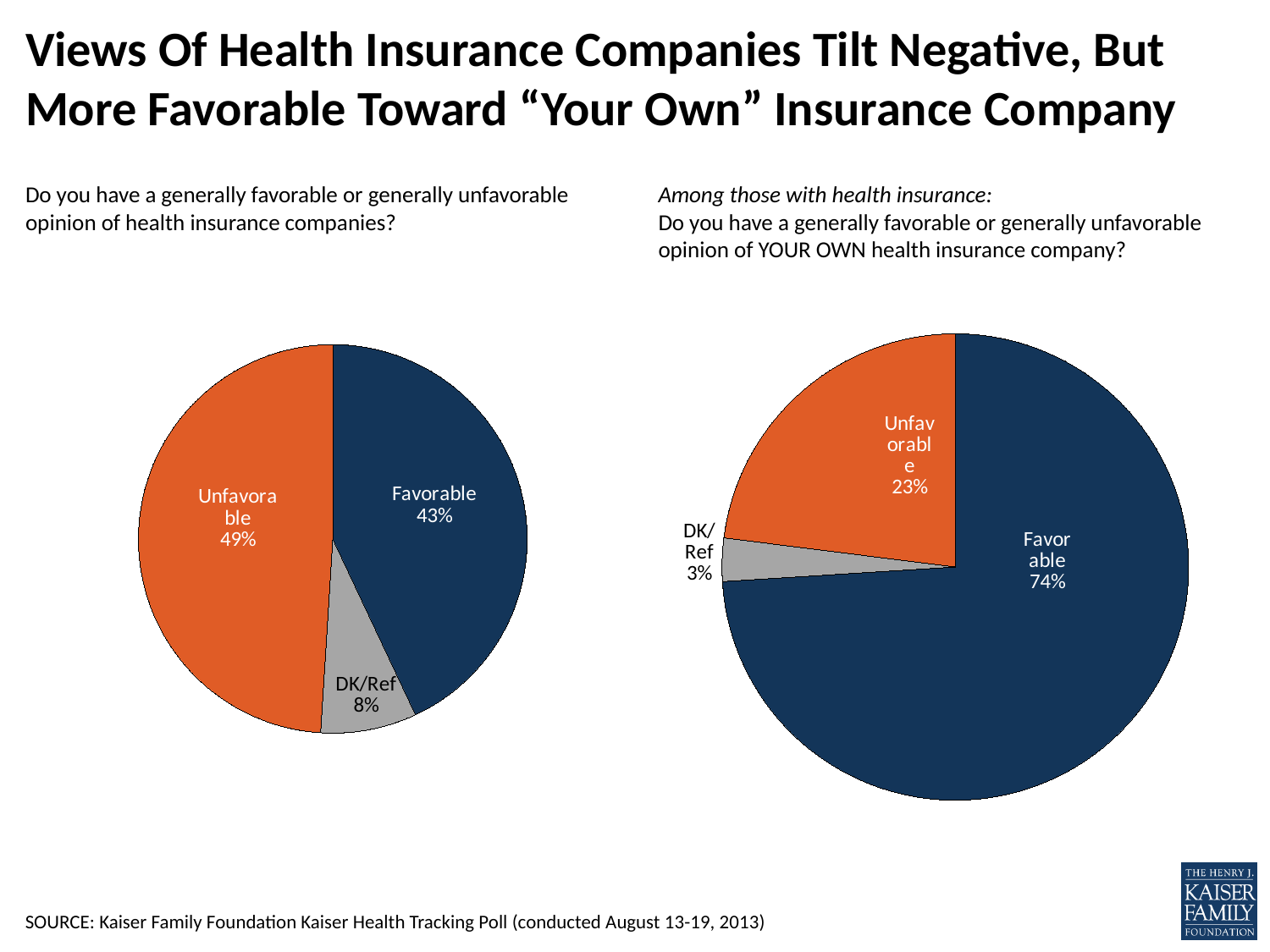
In the left pie chart (opinion of health insurance companies), what is the difference between the Unfavorable and Favorable shares? 6 percentage points In the right pie chart (opinion of YOUR OWN health insurance company), what is the difference between the Favorable and Unfavorable shares? 51 percentage points What type of chart is used on this slide? Pie chart In the right pie chart (opinion of YOUR OWN health insurance company), what colour is the Favorable slice? Dark blue Is the Favorable share larger in the left pie chart (health insurance companies) or the right pie chart (YOUR OWN health insurance company)? The right pie chart (YOUR OWN health insurance company) In the right pie chart (opinion of YOUR OWN health insurance company), what share of respondents are Favorable? 74% In the right pie chart (opinion of YOUR OWN health insurance company), what share of respondents are DK/Ref? 3% In the left pie chart (opinion of health insurance companies), what share of respondents are Favorable? 43% How many slices does the left pie chart (opinion of health insurance companies) have? 3 In the right pie chart (opinion of YOUR OWN health insurance company), which category has the smallest share? DK/Ref In the left pie chart (opinion of health insurance companies), what share of respondents are Unfavorable? 49% In the left pie chart (opinion of health insurance companies), which category has the largest share? Unfavorable